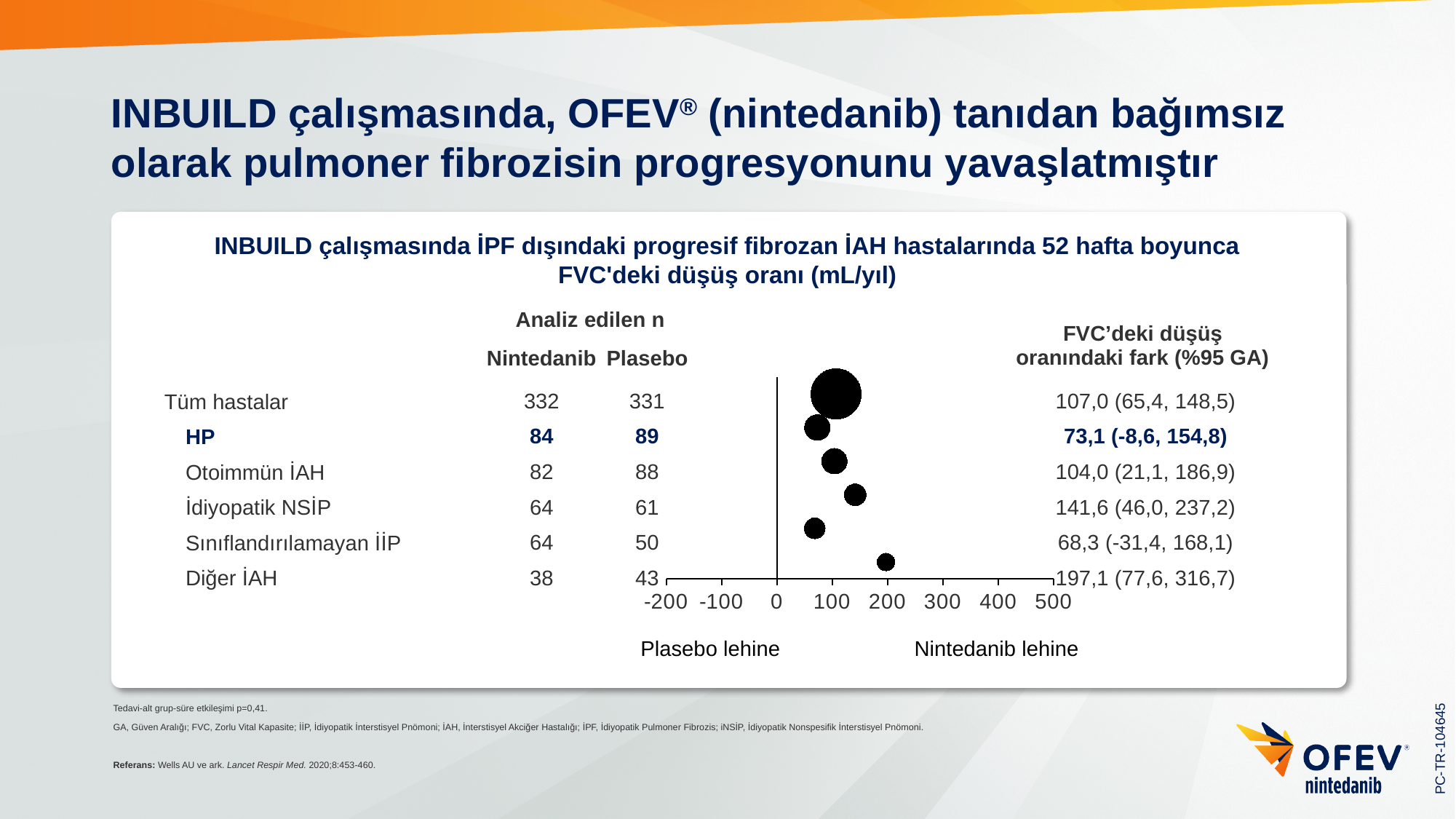
What is the lowest value shown on the x axis of the chart? -200 How many patients were analysed in the Nintedanib arm for the Otoimmün İAH subgroup? 82 What is the point estimate of the difference in FVC decline rate for İdiyopatik NSİP? 141,6 Which has a larger point estimate for the difference in FVC decline rate: İdiyopatik NSİP or Otoimmün İAH? İdiyopatik NSİP How many subgroups (including Tüm hastalar) are plotted in the chart? 6 What is the difference in the rate of FVC decline for the Diğer İAH subgroup? 197,1 (77,6, 316,7) Which subgroup has the lowest point estimate for the difference in FVC decline rate? Sınıflandırılamayan İİP What is the difference in the rate of FVC decline (mL/yıl) for the Tüm hastalar group? 107,0 (65,4, 148,5) What is the difference between the point estimates for Diğer İAH and HP? 124,0 What is the difference in the rate of FVC decline for the HP subgroup? 73,1 (-8,6, 154,8) Which subgroup has the highest point estimate for the difference in FVC decline rate? Diğer İAH Which side of the chart is labelled 'Nintedanib lehine'? The right side